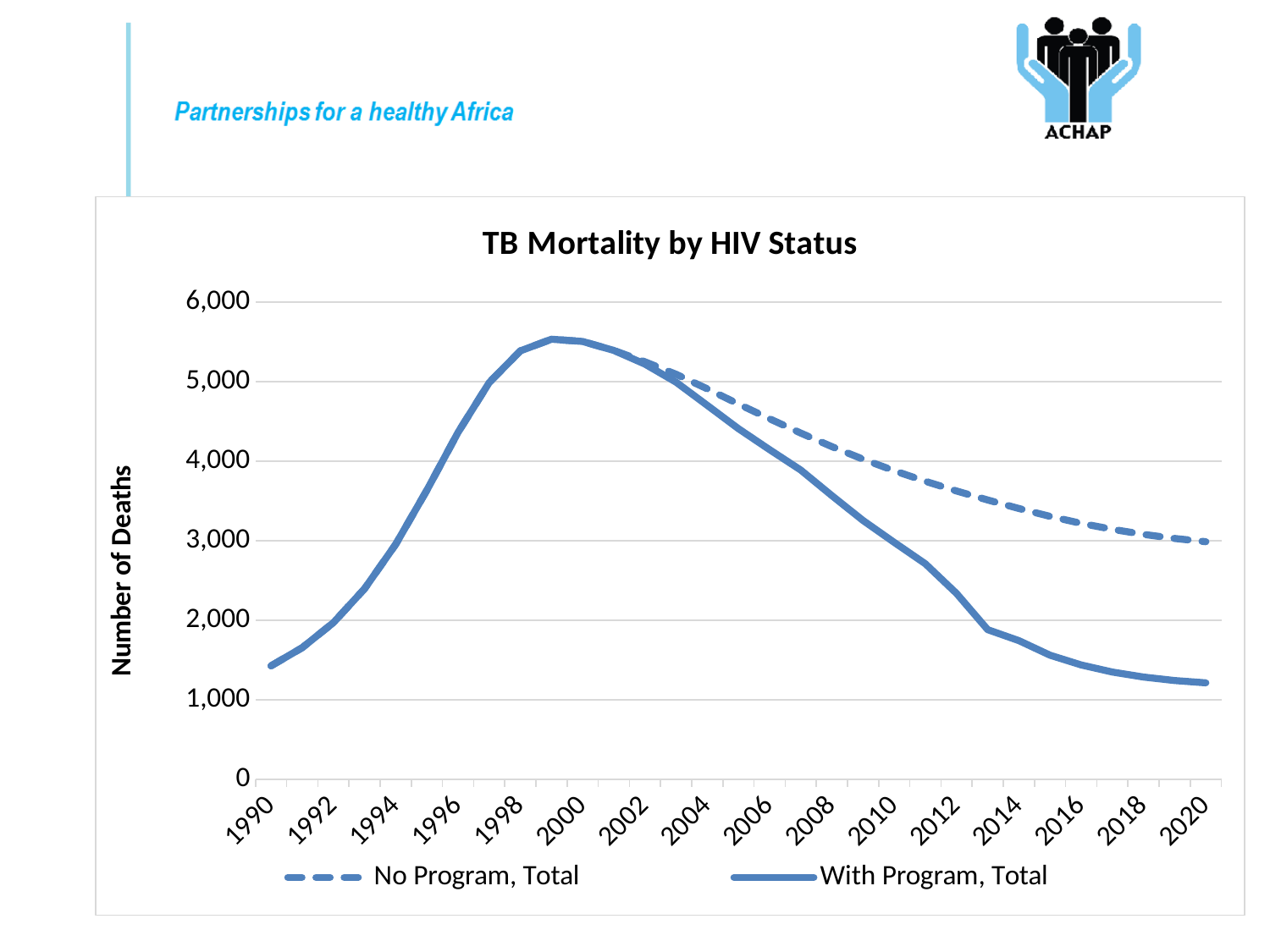
What is the label on the vertical axis? Number of Deaths Is the value for No Program, Total in 2020 greater or less than 4,000? less What kind of chart is shown on the slide? line chart What is the title of the chart? TB Mortality by HIV Status Does the With Program, Total line rise or fall between 1990 and 1998? rise In 2020, which series has the higher value, No Program, Total or With Program, Total? No Program, Total Is the value for With Program, Total in 1990 greater or less than 1,000? greater Is the value for No Program, Total in 2010 greater or less than 3,000? greater Does the With Program, Total line rise or fall between 2000 and 2020? fall How many series does the legend list? 2